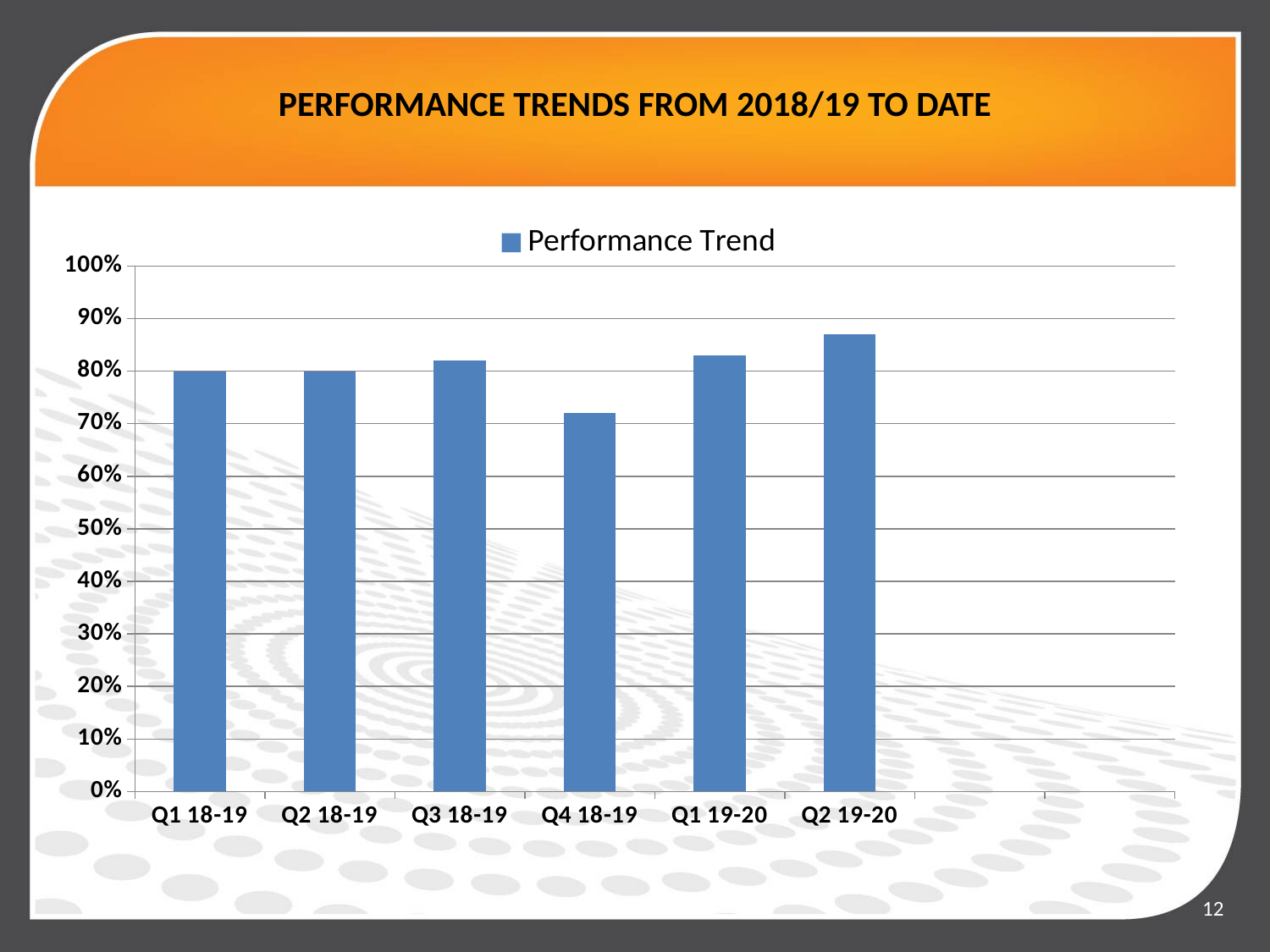
From Q4 18-19 to Q2 19-20, do the values rise or fall? rise Which quarter has the lowest value? Q4 18-19 What is the name of the series shown in the legend? Performance Trend What kind of chart is shown on the slide? bar chart Is the value for Q1 19-20 greater or less than 80%? greater Which quarter has the highest value? Q2 19-20 How many quarters are plotted on the chart? 6 What is the title of the slide containing the chart? PERFORMANCE TRENDS FROM 2018/19 TO DATE How many series does the legend list? 1 Is the value for Q2 19-20 greater or less than 90%? less Which is larger, the value for Q4 18-19 or the value for Q1 19-20? Q1 19-20 Is the value for Q4 18-19 greater or less than 80%? less